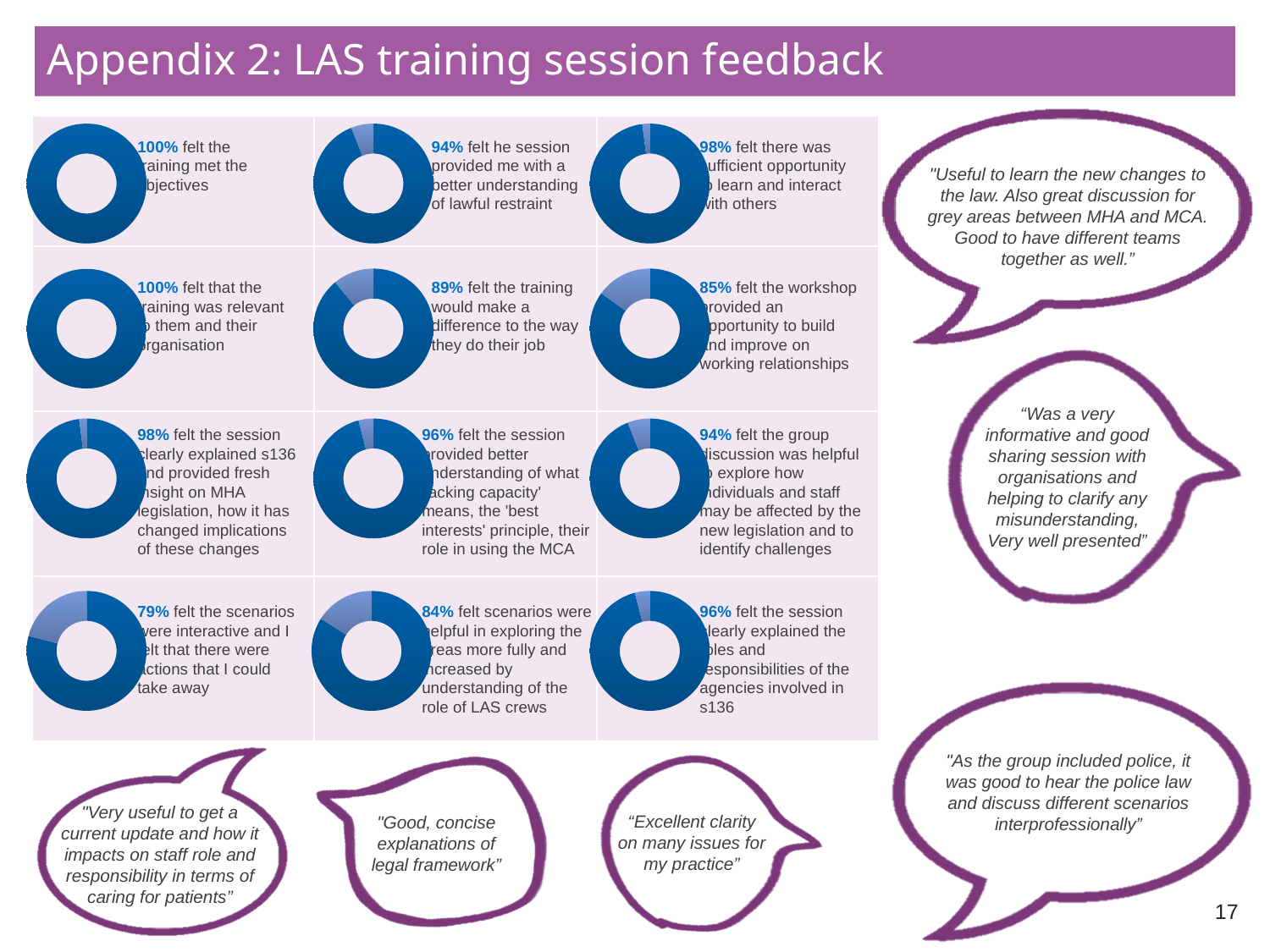
What percentage felt the session clearly explained the roles and responsibilities of the agencies involved in s136, according to the bottom-right donut chart? 96% Which is larger: the percentage who felt the training would make a difference to the way they do their job (second row, middle) or the percentage who felt the workshop provided an opportunity to build working relationships (second row, right)? The training would make a difference to the way they do their job (89%) What percentage felt the scenarios were interactive with actions they could take away, according to the bottom-left donut chart? 79% What kind of chart is used to show each feedback percentage on the slide? Donut (pie) chart What is the difference between the percentage who felt the training met the objectives (top-left chart) and the percentage who felt the scenarios were interactive (bottom-left chart)? 21% What percentage felt the workshop provided an opportunity to build and improve on working relationships, according to the right-hand chart in the second row? 85% In the bottom-middle donut chart, what share of the pie represents those who felt scenarios were helpful in exploring the areas more fully? 84% Which feedback statement has the lowest percentage among the donut charts on the slide? 79% felt the scenarios were interactive and I felt that there were actions that I could take away How many donut charts are shown on the slide? 12 What percentage felt the session provided a better understanding of lawful restraint, according to the top-middle donut chart? 94% What percentage of respondents felt the training met the objectives, according to the top-left donut chart? 100% What percentage felt the training would make a difference to the way they do their job, according to the middle chart in the second row? 89%